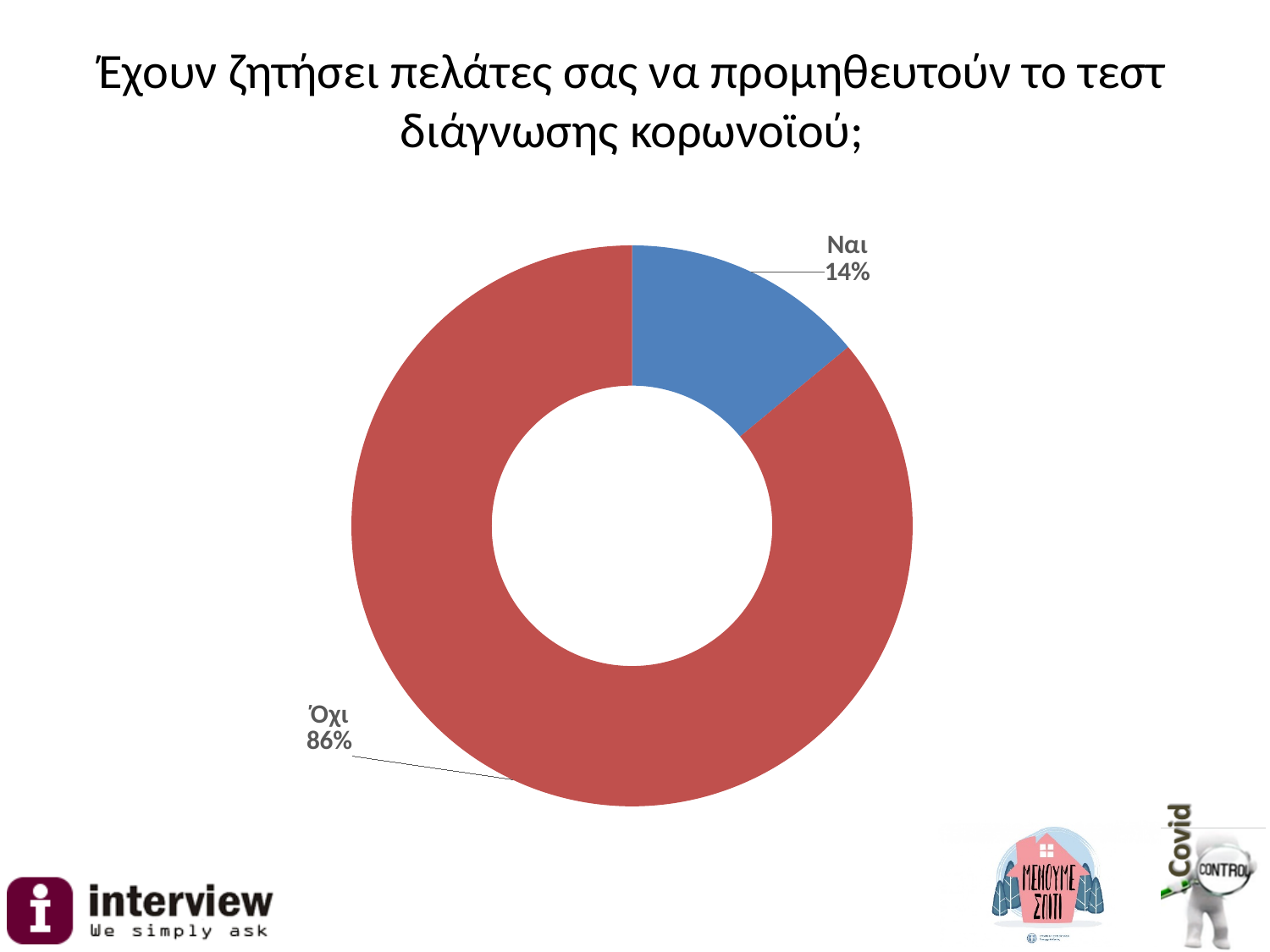
Which category has the smallest slice? Ναι What is the total of the two slice percentages shown? 100% How many slices does the chart have? 2 What is the difference in percentage points between the 'Όχι' and 'Ναι' slices? 72 What share of the pie is labelled 'Ναι'? 14% Is the share for 'Ναι' greater or less than 50%? less What share of the pie is labelled 'Όχι'? 86% What colour is the 'Ναι' slice? Blue Which slice is larger, 'Ναι' or 'Όχι'? Όχι What kind of chart is shown on the slide? Pie chart (doughnut) What colour is the 'Όχι' slice? Red Which category has the largest slice? Όχι